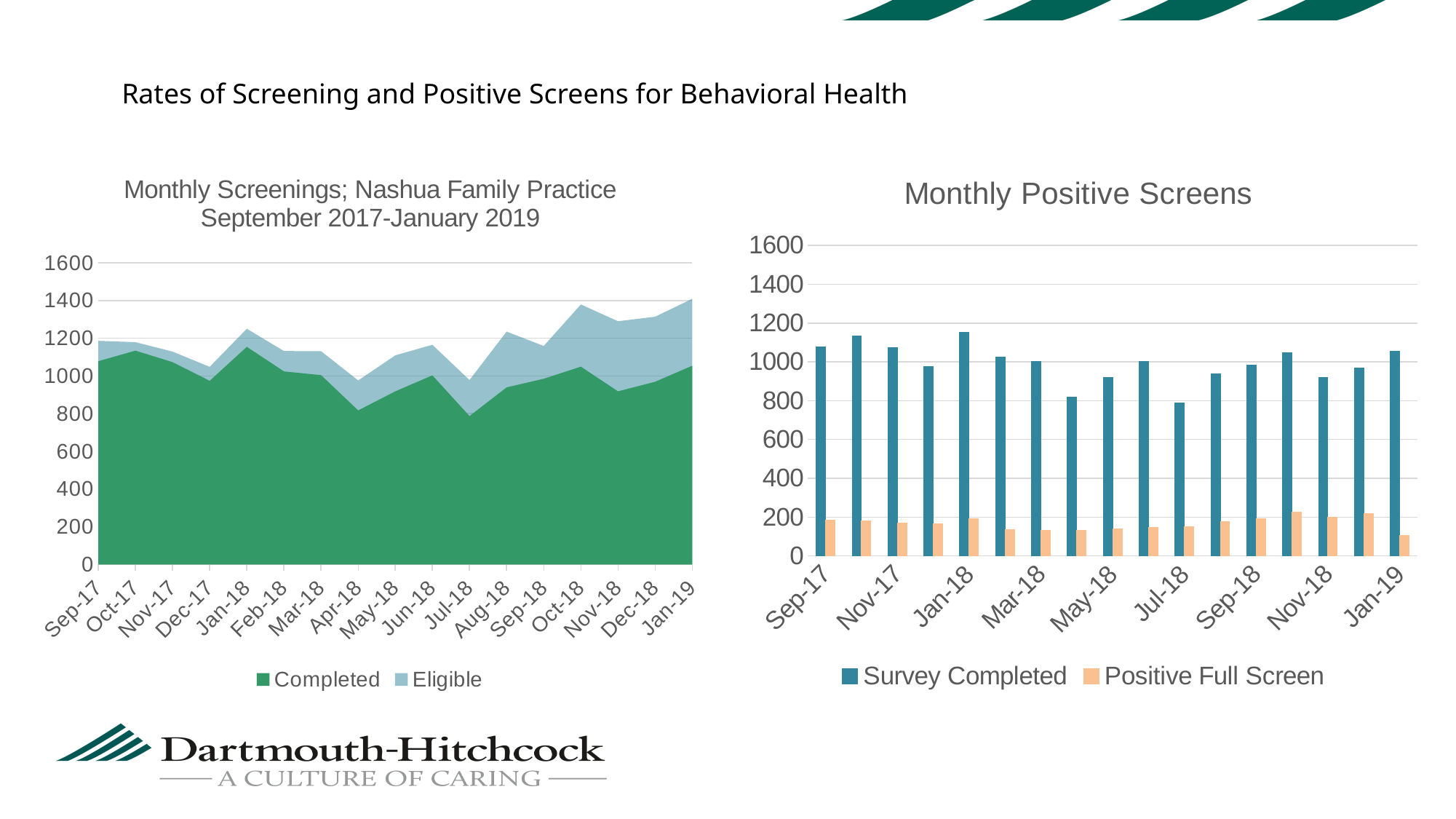
In the 'Monthly Positive Screens' chart, is the Survey Completed value for Apr-18 greater or less than 1000? less In the 'Monthly Screenings; Nashua Family Practice' chart, how many months are shown on the x axis? 17 In the 'Monthly Positive Screens' chart, what colour are the Positive Full Screen bars? orange In the 'Monthly Positive Screens' chart, how many series does the legend list? 2 In the 'Monthly Positive Screens' chart, which is larger: the Survey Completed value for Jan-18 or for Jul-18? Jan-18 What kind of chart is the 'Monthly Positive Screens' chart on the right? bar chart In the 'Monthly Positive Screens' chart, is the Survey Completed value for Jan-18 greater or less than 1000? greater In the 'Monthly Screenings; Nashua Family Practice' chart, is the Completed value for Apr-18 greater or less than 1000? less In the 'Monthly Screenings; Nashua Family Practice' chart, what are the two series listed in the legend? Completed and Eligible In the 'Monthly Positive Screens' chart, which month has the lowest Positive Full Screen value? Jan-19 What kind of chart is the 'Monthly Screenings; Nashua Family Practice' chart on the left? area chart